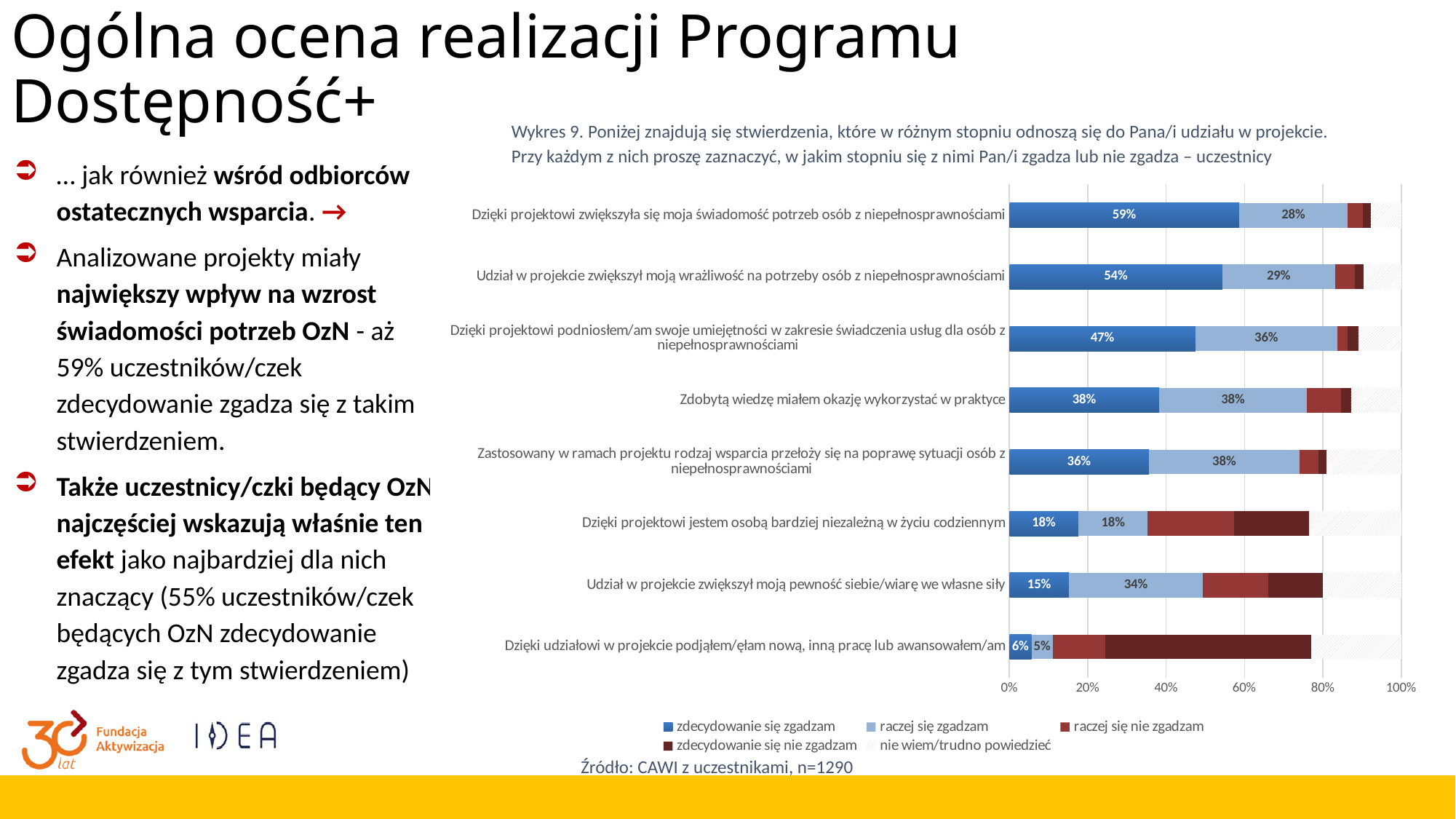
Which has a larger "raczej się zgadzam" value: the statement about raising skills (umiejętności) or the statement about increased sensitivity (wrażliwość)? The statement about raising skills (36%) Which statement has the lowest "zdecydowanie się zgadzam" share? Dzięki udziałowi w projekcie podjąłem/ęłam nową, inną pracę lub awansowałem/am According to the source note under the chart, how many participants were surveyed? n=1290 What type of chart is shown on the slide? Stacked horizontal bar chart Is the "zdecydowanie się nie zgadzam" value for the statement "Dzięki udziałowi w projekcie podjąłem/ęłam nową, inną pracę lub awansowałem/am" greater or less than 40%? greater What percentage of participants answered "zdecydowanie się zgadzam" to the statement "Zdobytą wiedzę miałem okazję wykorzystać w praktyce"? 38% What is the combined share of "zdecydowanie się zgadzam" and "raczej się zgadzam" for the statement "Dzięki projektowi zwiększyła się moja świadomość potrzeb osób z niepełnosprawnościami"? 87% What is the "raczej się zgadzam" value for the statement "Udział w projekcie zwiększył moją pewność siebie/wiarę we własne siły"? 34% Which statement has the highest "zdecydowanie się zgadzam" share? Dzięki projektowi zwiększyła się moja świadomość potrzeb osób z niepełnosprawnościami How many response categories does the legend list? 5 How many statements are shown in the chart? 8 What is the difference in percentage points between the "zdecydowanie się zgadzam" values for the statement about increased awareness (świadomość) and the statement about increased sensitivity (wrażliwość)? 5 percentage points